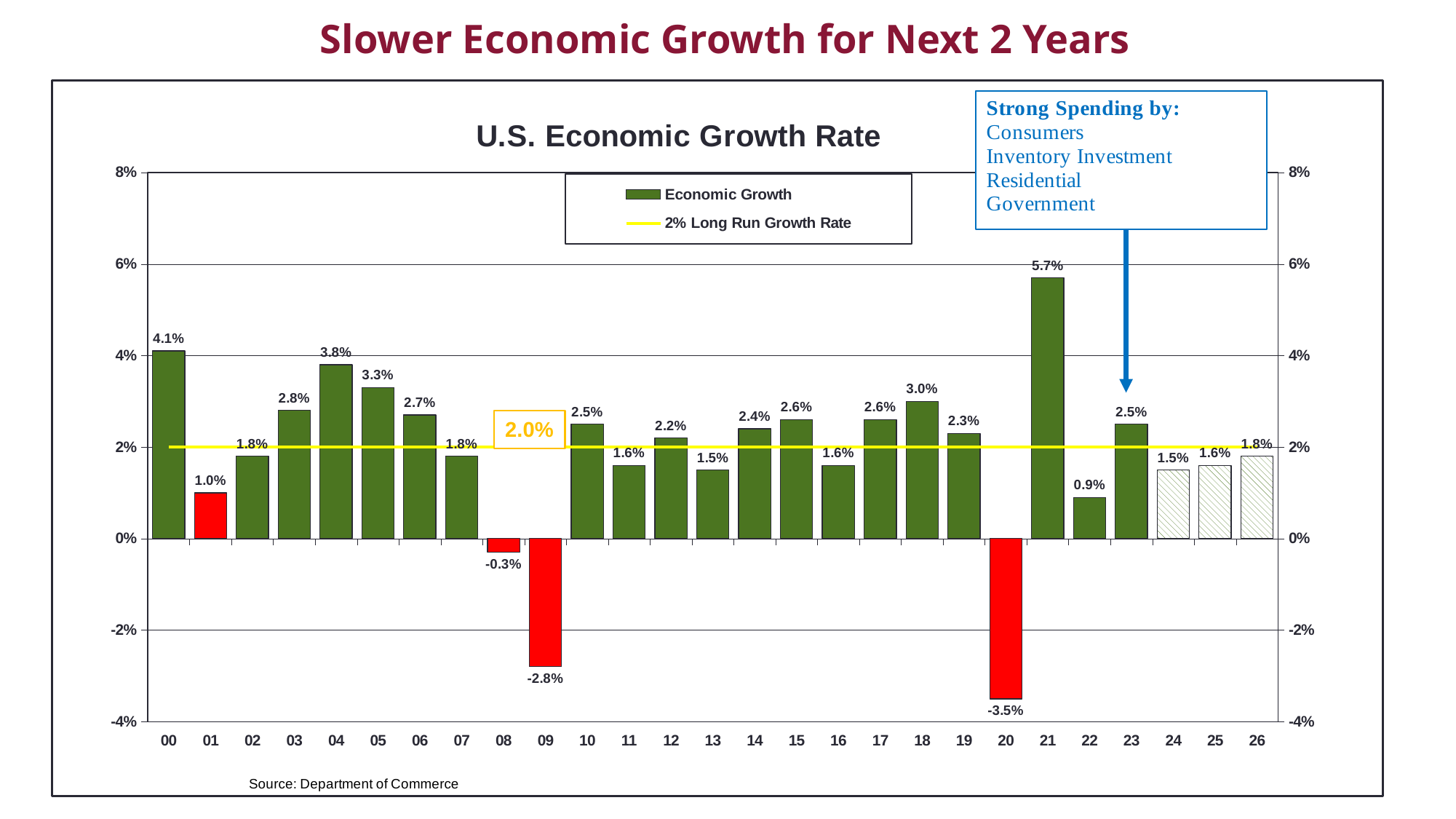
Which year has the highest economic growth rate? 21 What is the economic growth rate shown for 09? -2.8% Do the economic growth rates rise or fall from 24 to 26? Rise Which year has the lowest economic growth rate? 20 What is the title of the chart? U.S. Economic Growth Rate How many entries does the legend list? 2 What kind of chart is this? Combination bar and line chart What is the economic growth rate shown for 21? 5.7% What is the difference between the economic growth rate in 21 and in 22? 4.8% How many years are shown on the x axis? 27 Which year has a higher economic growth rate, 04 or 18? 04 What is the economic growth rate shown for 24? 1.5%